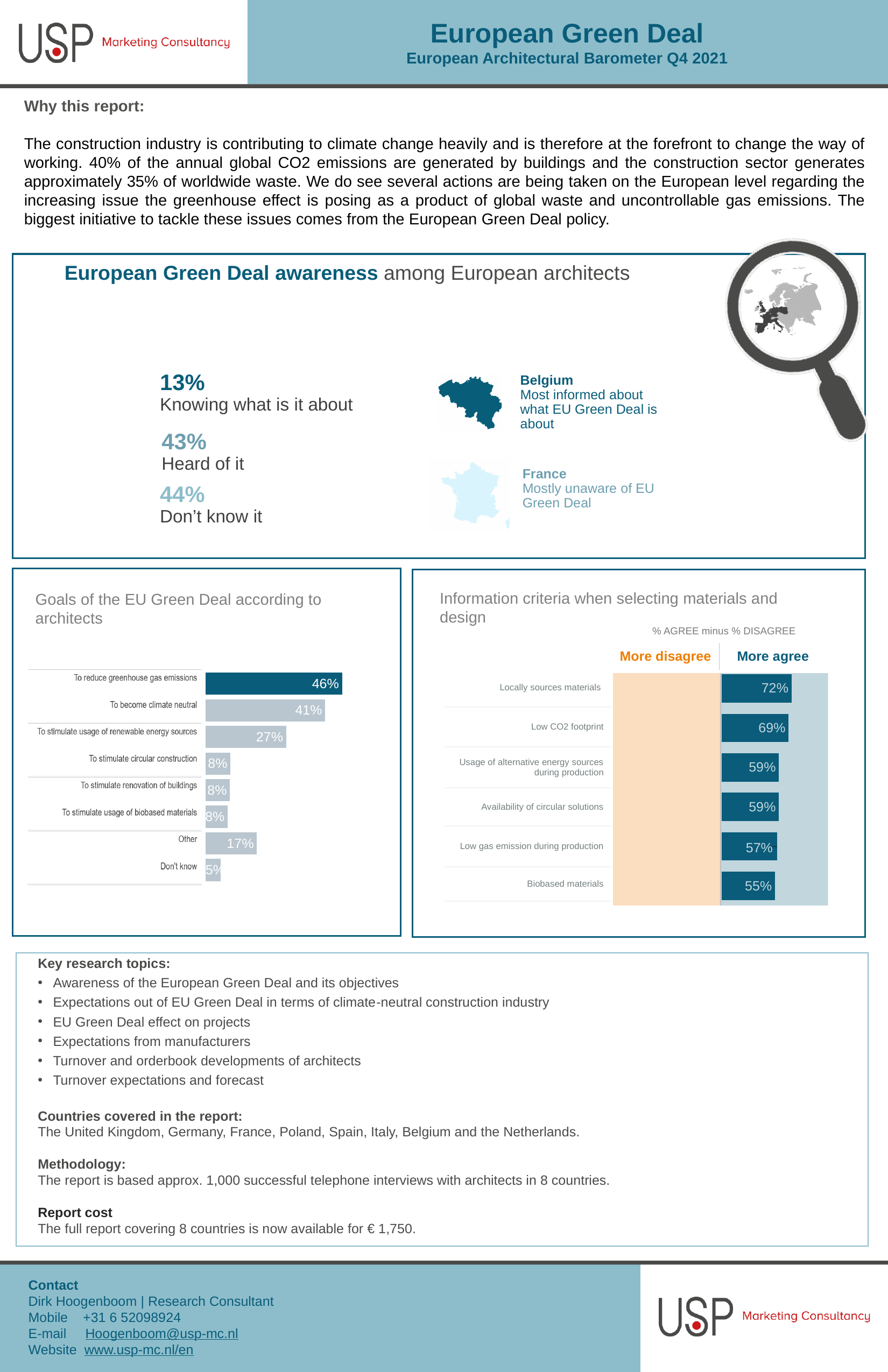
In the 'Goals of the EU Green Deal according to architects' chart, how many categories are shown? 8 In the 'Information criteria when selecting materials and design' chart, how many criteria are listed? 6 In the 'Information criteria when selecting materials and design' chart, which criterion has the highest value? Locally sources materials What kind of chart is 'Goals of the EU Green Deal according to architects'? Bar chart In the 'Goals of the EU Green Deal according to architects' chart, what is the value for 'To reduce greenhouse gas emissions'? 46% In the 'Goals of the EU Green Deal according to architects' chart, what is the difference between 'To reduce greenhouse gas emissions' and 'To become climate neutral'? 5% In the 'Goals of the EU Green Deal according to architects' chart, which category has the lowest value? Don't know In the 'Information criteria when selecting materials and design' chart, what measure do the bars represent according to the label above the chart? % AGREE minus % DISAGREE In the 'Information criteria when selecting materials and design' chart, what is the difference between 'Locally sources materials' and 'Biobased materials'? 17% In the 'Information criteria when selecting materials and design' chart, what is the value for 'Low CO2 footprint'? 69% In the 'Goals of the EU Green Deal according to architects' chart, which is larger: 'Other' or 'To stimulate circular construction'? Other In the 'Goals of the EU Green Deal according to architects' chart, what is the value for 'To stimulate usage of renewable energy sources'? 27%